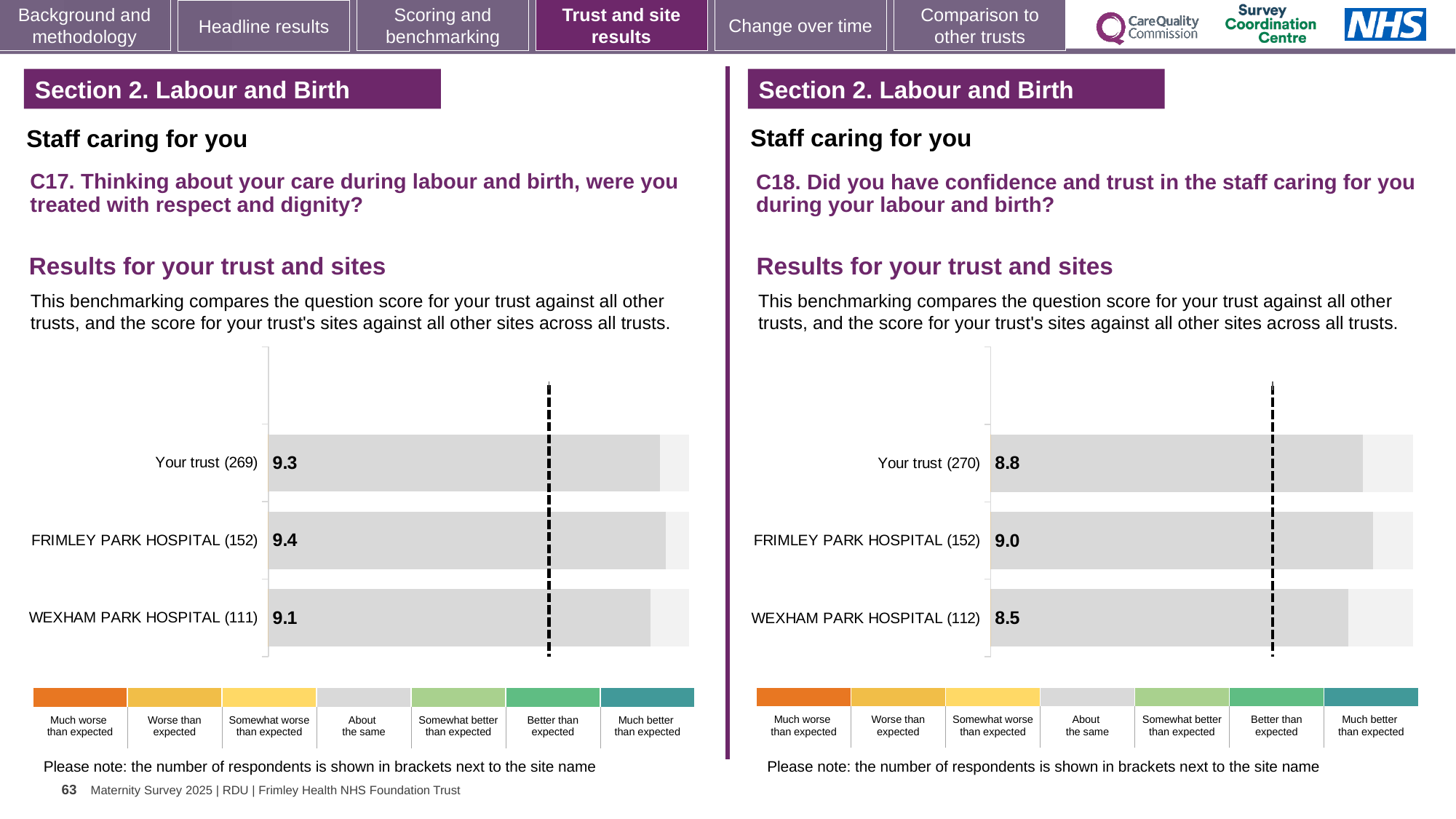
In the left chart (C17), what is the score for FRIMLEY PARK HOSPITAL? 9.4 In the right chart (C18), how many respondents are shown in brackets for Your trust? 270 In the left chart (C17), what is the score for Your trust? 9.3 In the right chart (C18), which has the larger score, Your trust or WEXHAM PARK HOSPITAL? Your trust What kind of chart is used on the left (C17) to show the results for the trust and sites? Bar chart How many bars are plotted in the right chart (C18)? 3 In the left chart (C17), what is the difference between the scores for FRIMLEY PARK HOSPITAL and WEXHAM PARK HOSPITAL? 0.3 In the right chart (C18), which site or trust has the highest score? FRIMLEY PARK HOSPITAL In the right chart (C18), what is the difference between the scores for FRIMLEY PARK HOSPITAL and Your trust? 0.2 In the left chart (C17), which site or trust has the lowest score? WEXHAM PARK HOSPITAL In the right chart (C18), what is the score for WEXHAM PARK HOSPITAL? 8.5 In the left chart (C17), how many respondents are shown in brackets for WEXHAM PARK HOSPITAL? 111